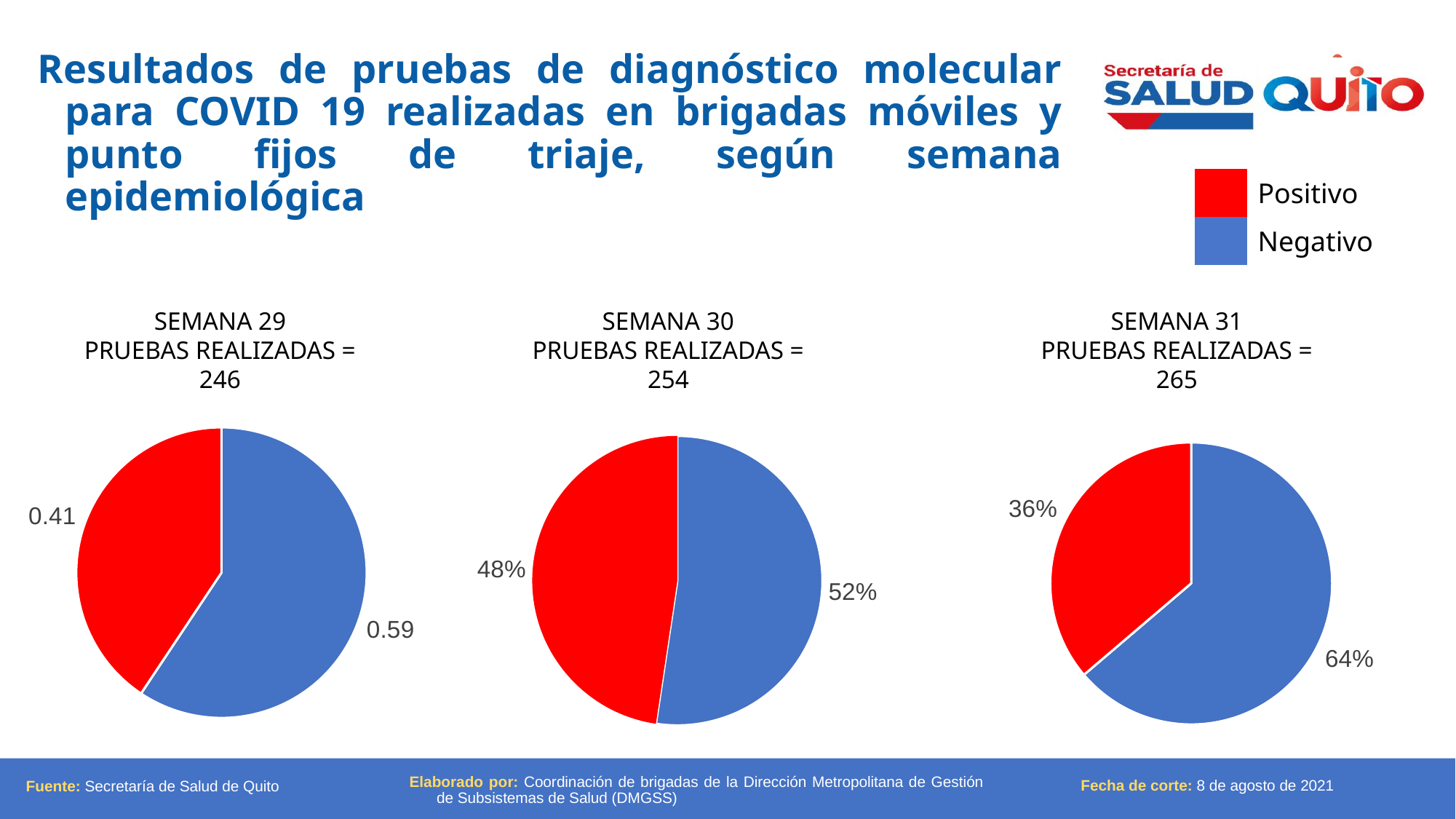
In the SEMANA 31 pie chart, what percentage is shown for Positivo? 36% According to the legend, which colour represents Positivo? Red In the SEMANA 29 pie chart, what is the value shown for Positivo? 0.41 In the SEMANA 30 pie chart, what percentage is shown for Negativo? 52% In the SEMANA 30 pie chart, what percentage is shown for Positivo? 48% How many slices does the SEMANA 29 pie chart have? 2 In the SEMANA 29 pie chart, what is the value shown for Negativo? 0.59 How many entries does the legend list? 2 In the SEMANA 31 pie chart, which slice is larger, Positivo or Negativo? Negativo In the SEMANA 31 pie chart, what percentage is shown for Negativo? 64% What kind of chart is used for SEMANA 30? Pie chart In the SEMANA 31 pie chart, what is the difference in percentage points between Negativo and Positivo? 28